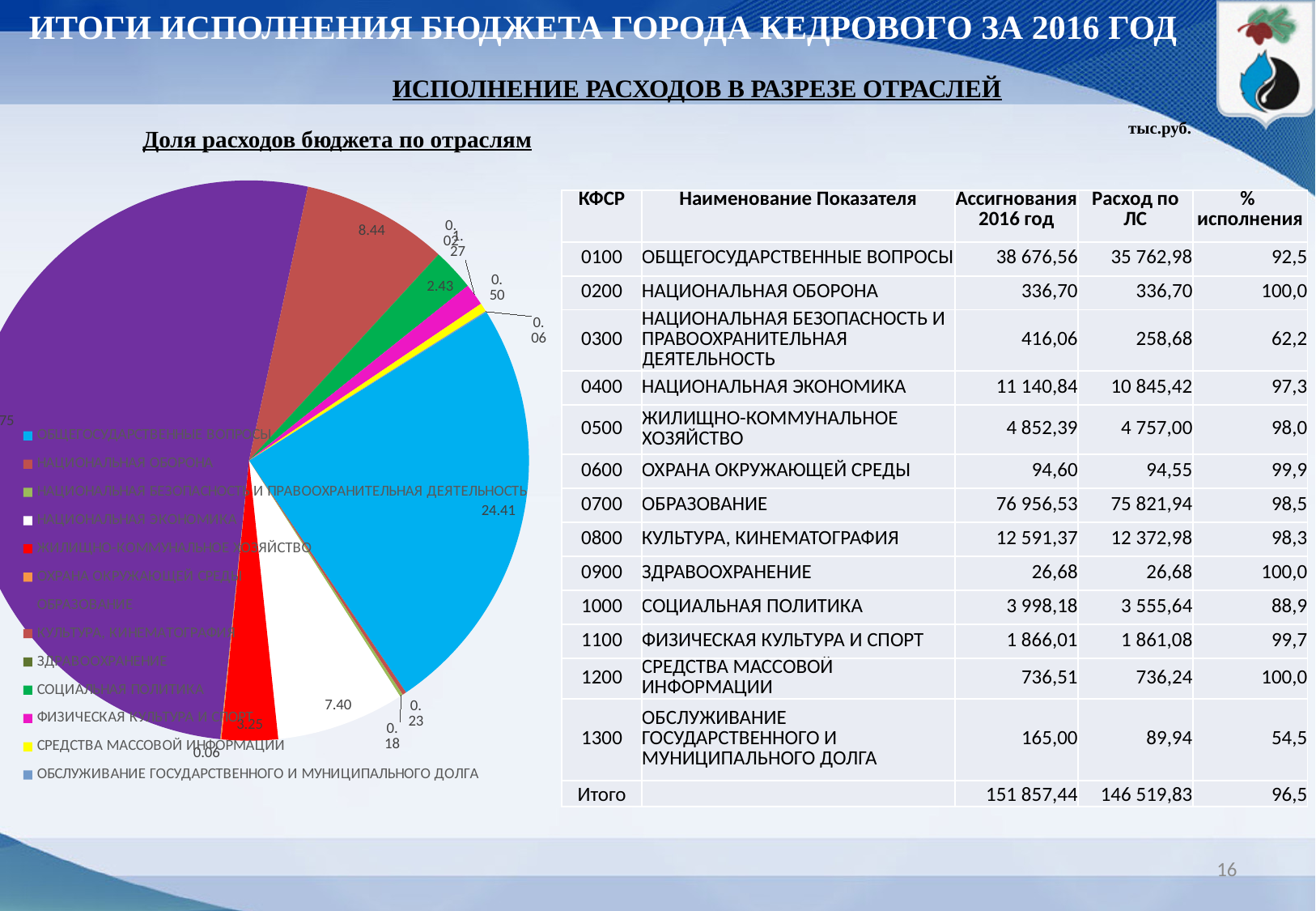
In the pie chart, what is the value shown for ОБЩЕГОСУДАРСТВЕННЫЕ ВОПРОСЫ? 24.41 What kind of chart is shown on the slide? pie chart What is the title of the chart on the slide? Доля расходов бюджета по отраслям In the pie chart, what is the difference between the values for ЖИЛИЩНО-КОММУНАЛЬНОЕ ХОЗЯЙСТВО and СОЦИАЛЬНАЯ ПОЛИТИКА? 0.82 How many categories does the pie chart legend list? 13 In the pie chart, what is the value shown for ФИЗИЧЕСКАЯ КУЛЬТУРА И СПОРТ? 1.27 In the pie chart, which is larger: ОБЩЕГОСУДАРСТВЕННЫЕ ВОПРОСЫ or НАЦИОНАЛЬНАЯ ЭКОНОМИКА? ОБЩЕГОСУДАРСТВЕННЫЕ ВОПРОСЫ In the pie chart, what is the value shown for СРЕДСТВА МАССОВОЙ ИНФОРМАЦИИ? 0.50 In the pie chart, what is the value shown for НАЦИОНАЛЬНАЯ ЭКОНОМИКА? 7.40 In the pie chart, what is the value shown for ЖИЛИЩНО-КОММУНАЛЬНОЕ ХОЗЯЙСТВО? 3.25 In the pie chart, what is the difference between the values for ОБЩЕГОСУДАРСТВЕННЫЕ ВОПРОСЫ and НАЦИОНАЛЬНАЯ ЭКОНОМИКА? 17.01 In the pie chart, what is the value shown for СОЦИАЛЬНАЯ ПОЛИТИКА? 2.43